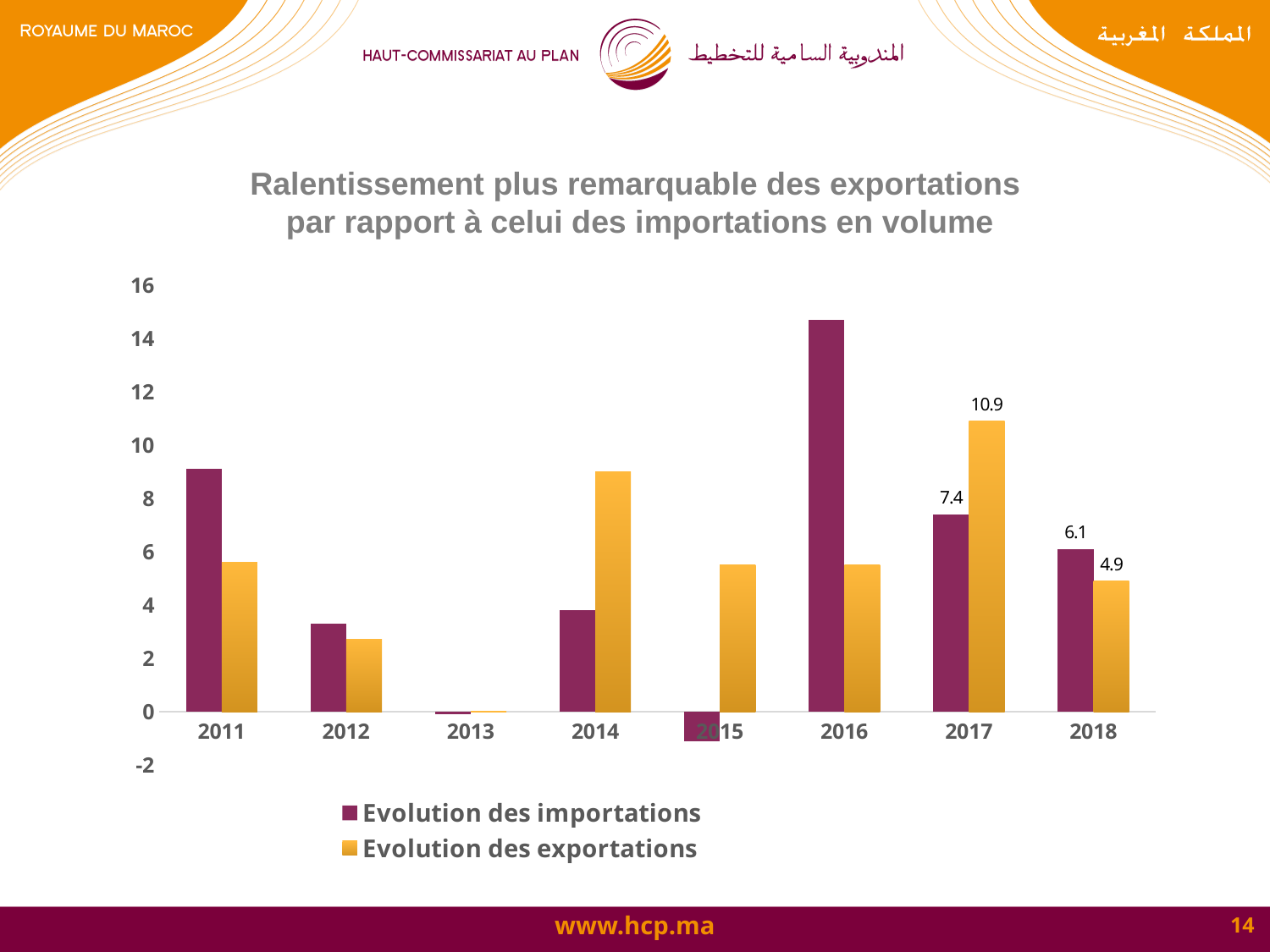
In which year is Evolution des importations highest? 2016 What kind of chart is shown on the slide? Bar chart What is the value of Evolution des exportations for 2017? 10.9 What is the value of Evolution des exportations for 2018? 4.9 In which year is Evolution des importations lowest? 2015 Is the value of Evolution des exportations for 2014 greater or less than 8? greater How many years are shown on the x axis? 8 What is the value of Evolution des importations for 2017? 7.4 What is the difference between Evolution des exportations and Evolution des importations in 2017? 3.5 In 2018, which is larger: Evolution des importations or Evolution des exportations? Evolution des importations How many series does the legend list? 2 Is the value of Evolution des importations for 2016 greater or less than 14? greater